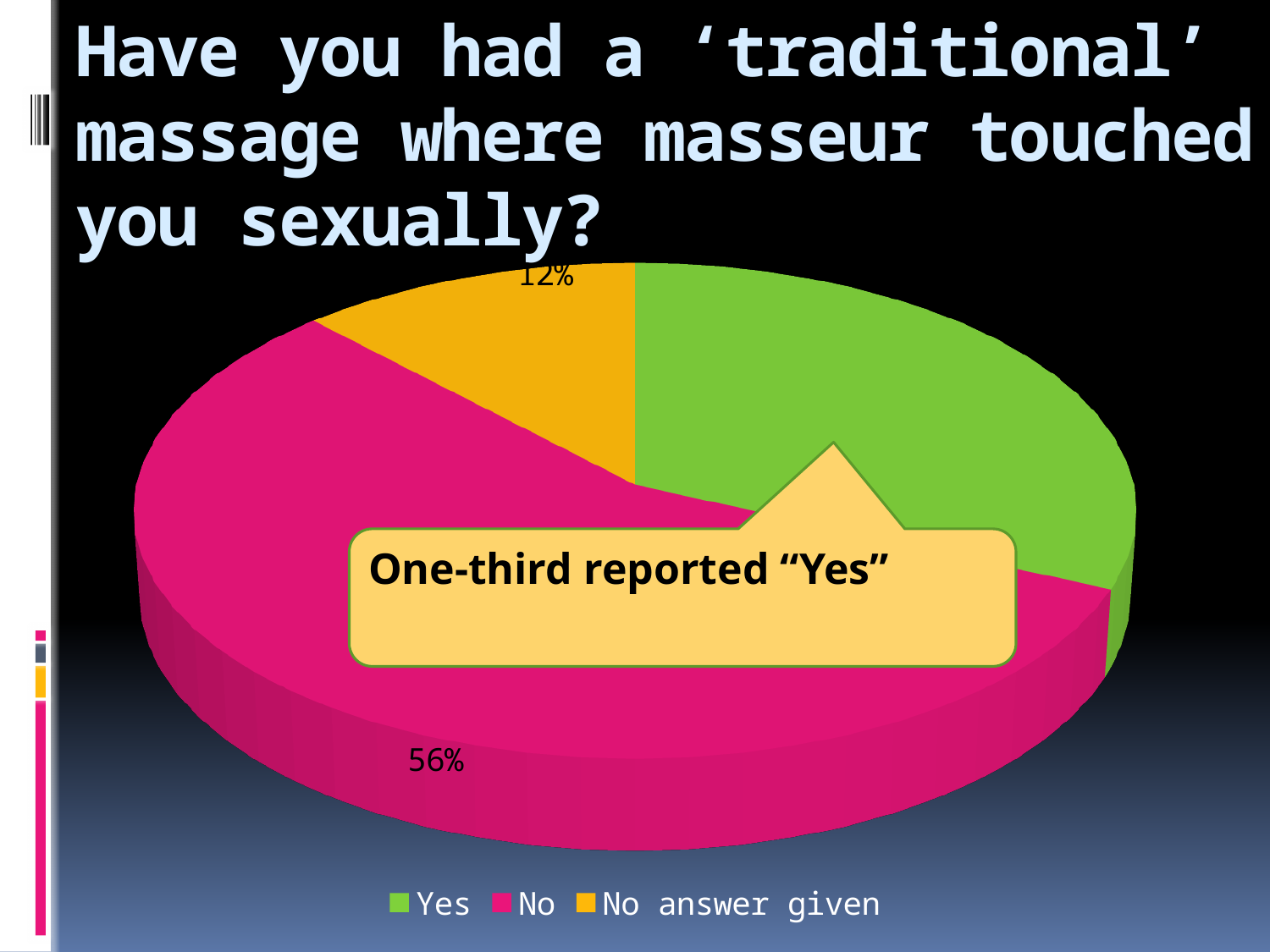
What percentage of respondents answered "No"? 56% What does the callout box on the chart say? One-third reported "Yes" How many response categories does the pie chart show? 3 What kind of chart is shown on the slide? Pie chart How many entries does the legend list? 3 What percentage is shown for "No answer given"? 12% By how many percentage points does "No" exceed "No answer given"? 44% What colour represents the "Yes" category in the pie chart? Green Which is larger, the "No" slice or the "No answer given" slice? No Which response category has the smallest slice of the pie? No answer given Which response category has the largest slice of the pie? No Which is larger, the "Yes" slice or the "No answer given" slice? Yes